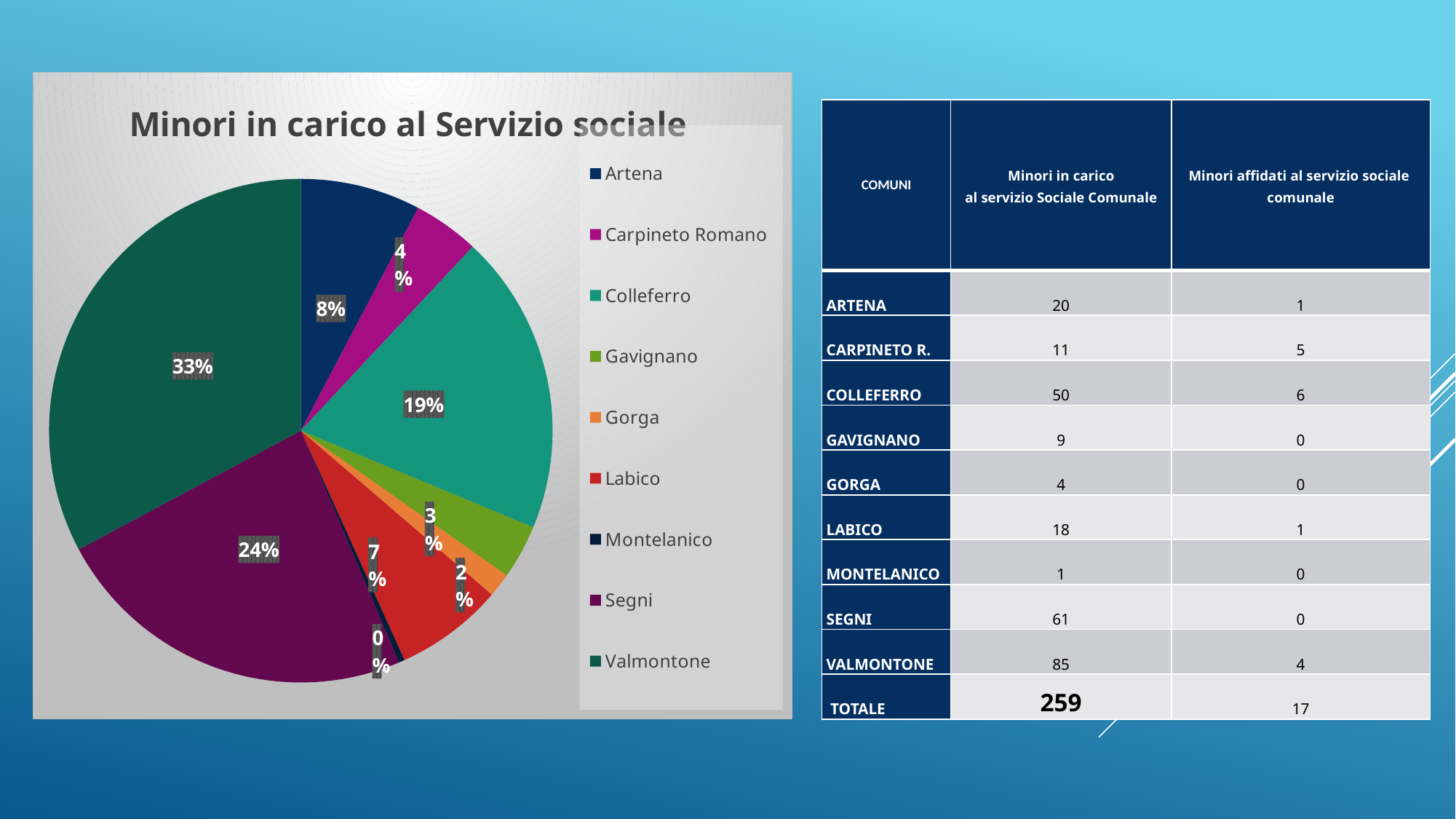
What percentage of the pie chart does Colleferro represent? 19% What type of chart is shown on the slide? pie chart What percentage of the pie chart does Artena represent? 8% Which category has the smallest slice in the pie chart? Montelanico What percentage of the pie chart does Valmontone represent? 33% Which category has the largest slice in the pie chart? Valmontone What percentage of the pie chart does Gorga represent? 2% What is the difference in percentage points between Valmontone and Segni in the pie chart? 9 How many slices does the pie chart have? 9 Which slice is larger in the pie chart, Labico or Carpineto Romano? Labico What percentage of the pie chart does Segni represent? 24% What is the title of the pie chart? Minori in carico al Servizio sociale